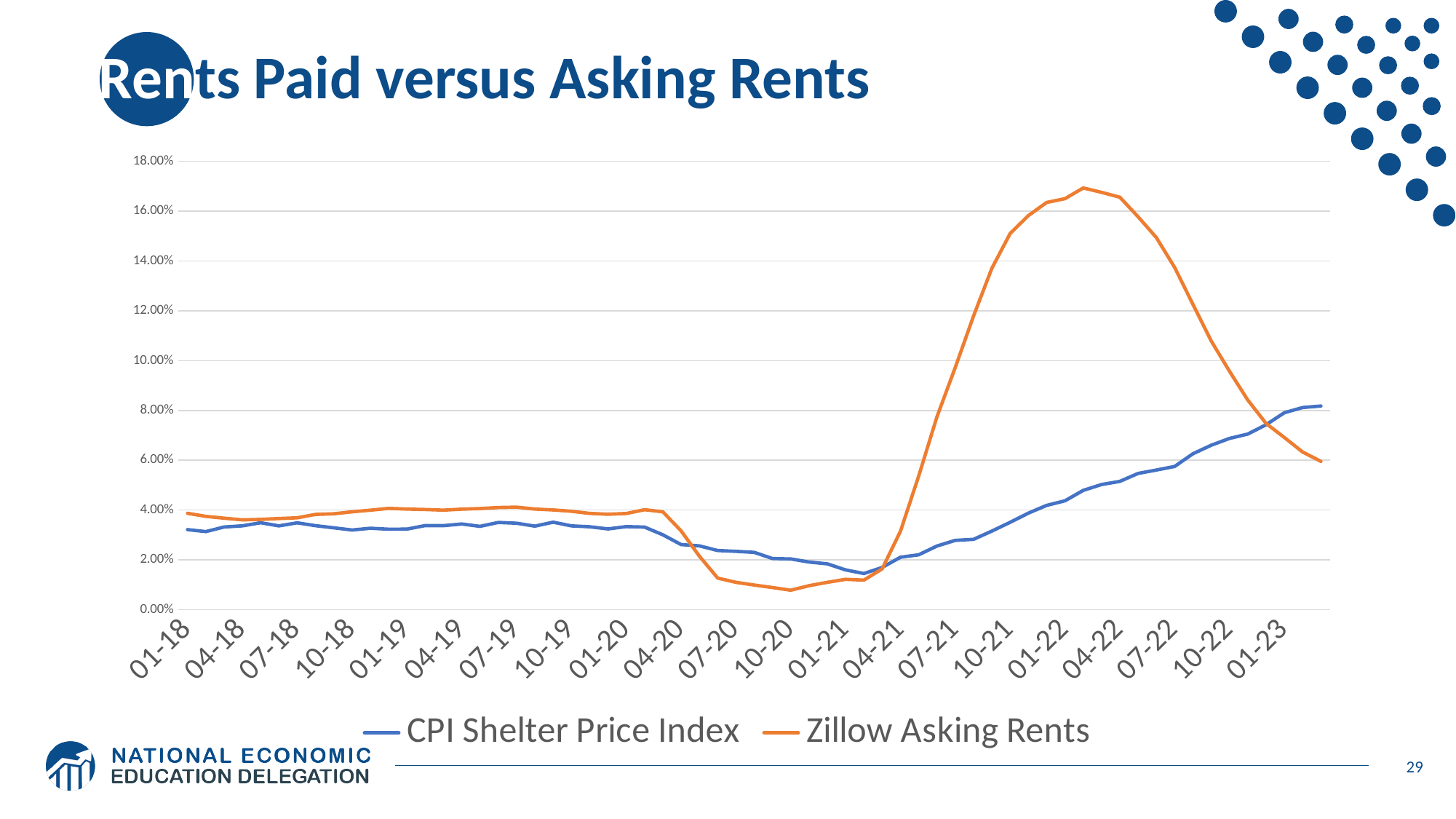
Is the value for CPI Shelter Price Index at 01-18 greater or less than 4.00%? less How many date labels are shown on the x axis? 21 Does the Zillow Asking Rents line rise or fall between 04-22 and 01-23? fall Is the value for Zillow Asking Rents at 01-22 greater or less than 14.00%? greater How many series does the legend list? 2 What is the title of the chart on the slide? Rents Paid versus Asking Rents Which series is drawn in orange? Zillow Asking Rents Is the value for CPI Shelter Price Index at 01-23 greater or less than 6.00%? greater Which series reaches the highest value on the chart? Zillow Asking Rents At 01-22, which series has the higher value, CPI Shelter Price Index or Zillow Asking Rents? Zillow Asking Rents What kind of chart is shown on the slide? line chart